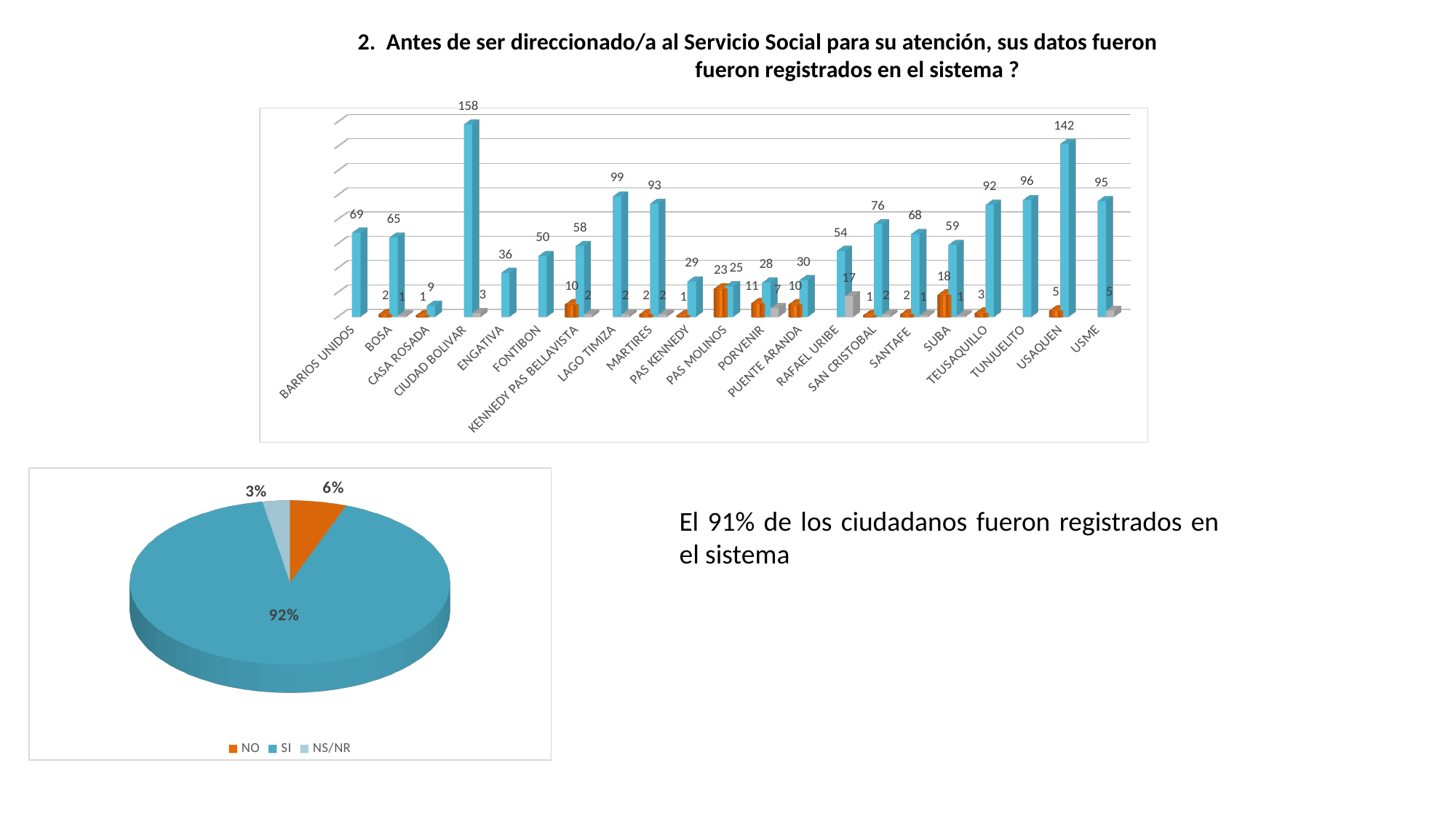
In the bar chart, what is the value of the tall blue bar for CIUDAD BOLIVAR? 158 In the bar chart, what is the value of the blue bar for USAQUEN? 142 In the bar chart, which category has the highest blue bar? CIUDAD BOLIVAR What kind of chart is the chart at the bottom left of the slide? Pie chart How many entries does the legend of the pie chart list? 3 In the pie chart, what share does the SI slice have? 92% In the bar chart, which has the larger blue bar value, LAGO TIMIZA or MARTIRES? LAGO TIMIZA In the pie chart, which slice is the smallest? NS/NR In the bar chart, what is the difference between the blue bar values for CIUDAD BOLIVAR and USAQUEN? 16 In the bar chart, what is the value of the orange bar for SUBA? 18 In the bar chart, what is the value of the grey bar for RAFAEL URIBE? 17 How many categories are shown on the x axis of the bar chart? 21